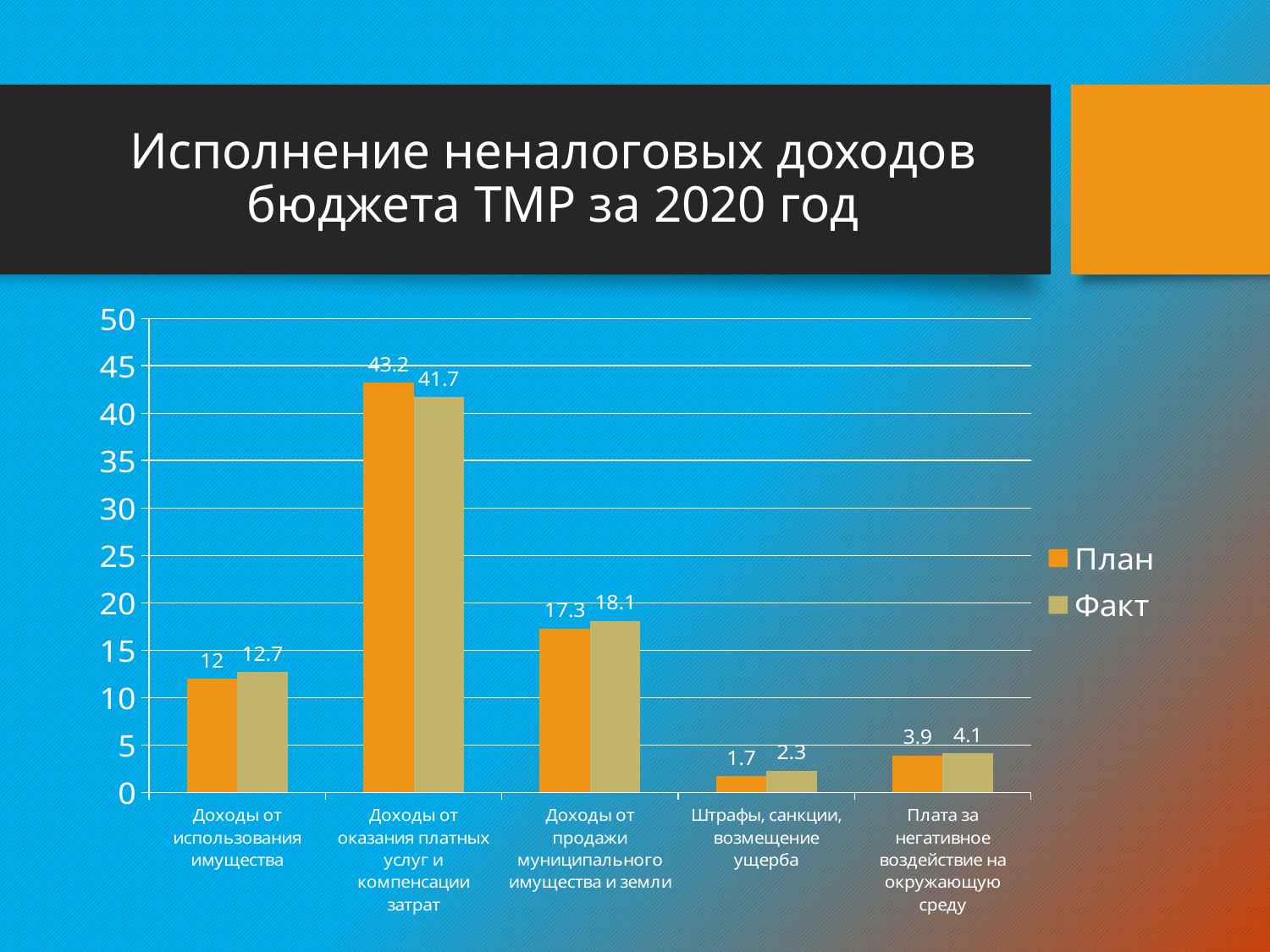
How many series does the legend list? 2 What is the Факт value for Штрафы, санкции, возмещение ущерба? 2.3 Is the Факт value for Доходы от продажи муниципального имущества и земли greater or less than 20? less What is the План value for Доходы от оказания платных услуг и компенсации затрат? 43.2 Which is larger for Доходы от использования имущества: План or Факт? Факт Which category has the highest Факт value? Доходы от оказания платных услуг и компенсации затрат How many categories are shown on the x axis? 5 Which category has the lowest План value? Штрафы, санкции, возмещение ущерба What kind of chart is shown on the slide? bar chart What is the difference between the План and Факт values for Доходы от оказания платных услуг и компенсации затрат? 1.5 What is the title of the slide? Исполнение неналоговых доходов бюджета ТМР за 2020 год What is the Факт value for Доходы от продажи муниципального имущества и земли? 18.1